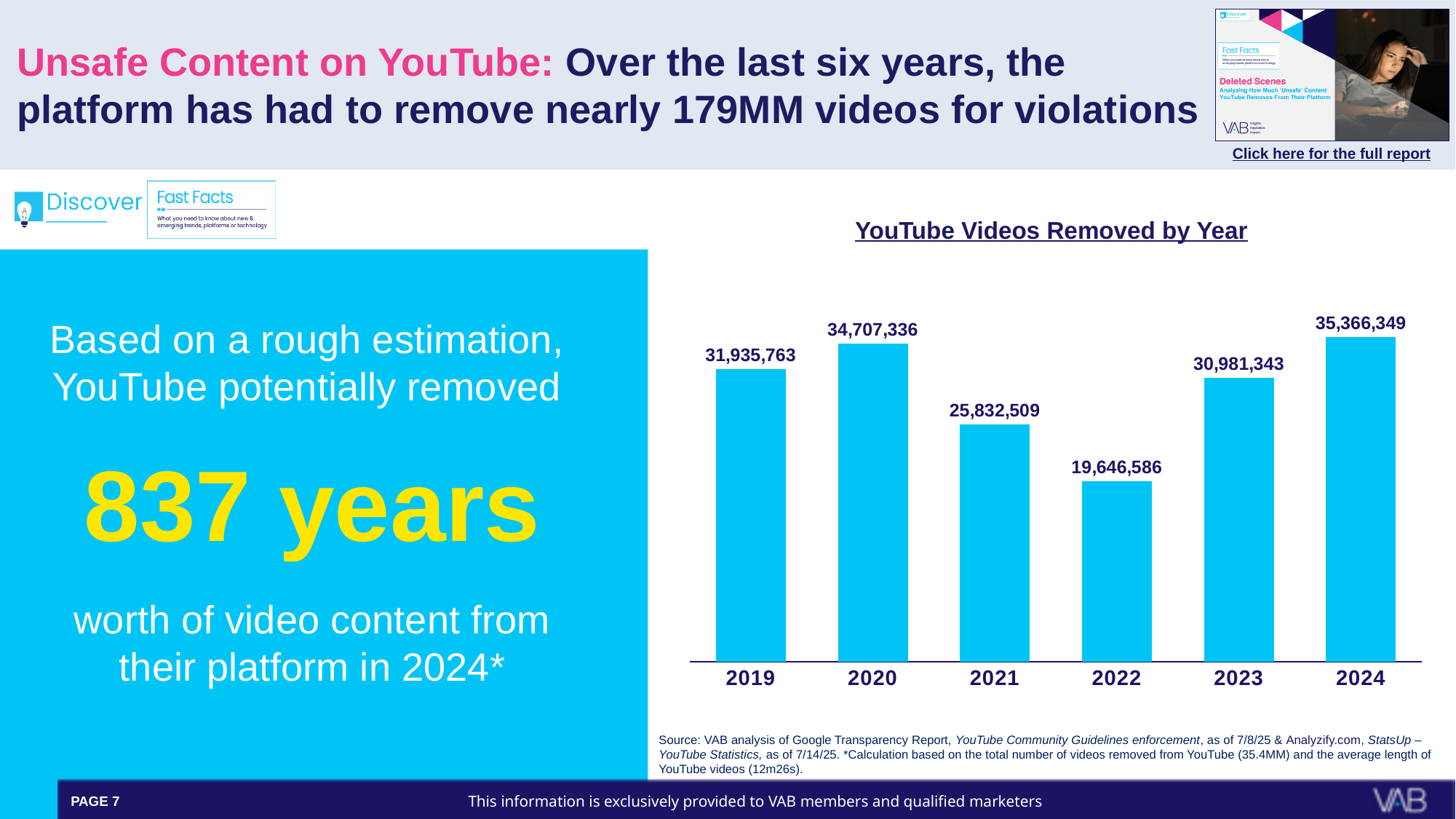
Do the values rise or fall from 2022 to 2024? Rise Which year has the highest number of videos removed? 2024 How many videos were removed from YouTube in 2022 according to the chart? 19,646,586 What value does the chart show for 2024? 35,366,349 How many years are shown on the chart? 6 Which year had more videos removed, 2019 or 2023? 2019 What is the title of the chart? YouTube Videos Removed by Year What is the difference between the number of videos removed in 2024 and in 2023? 4,385,006 What type of chart is used to show YouTube videos removed by year? Bar chart How many more videos were removed in 2021 than in 2022? 6,185,923 Which year has the lowest number of videos removed? 2022 What is the number of YouTube videos removed in 2020? 34,707,336